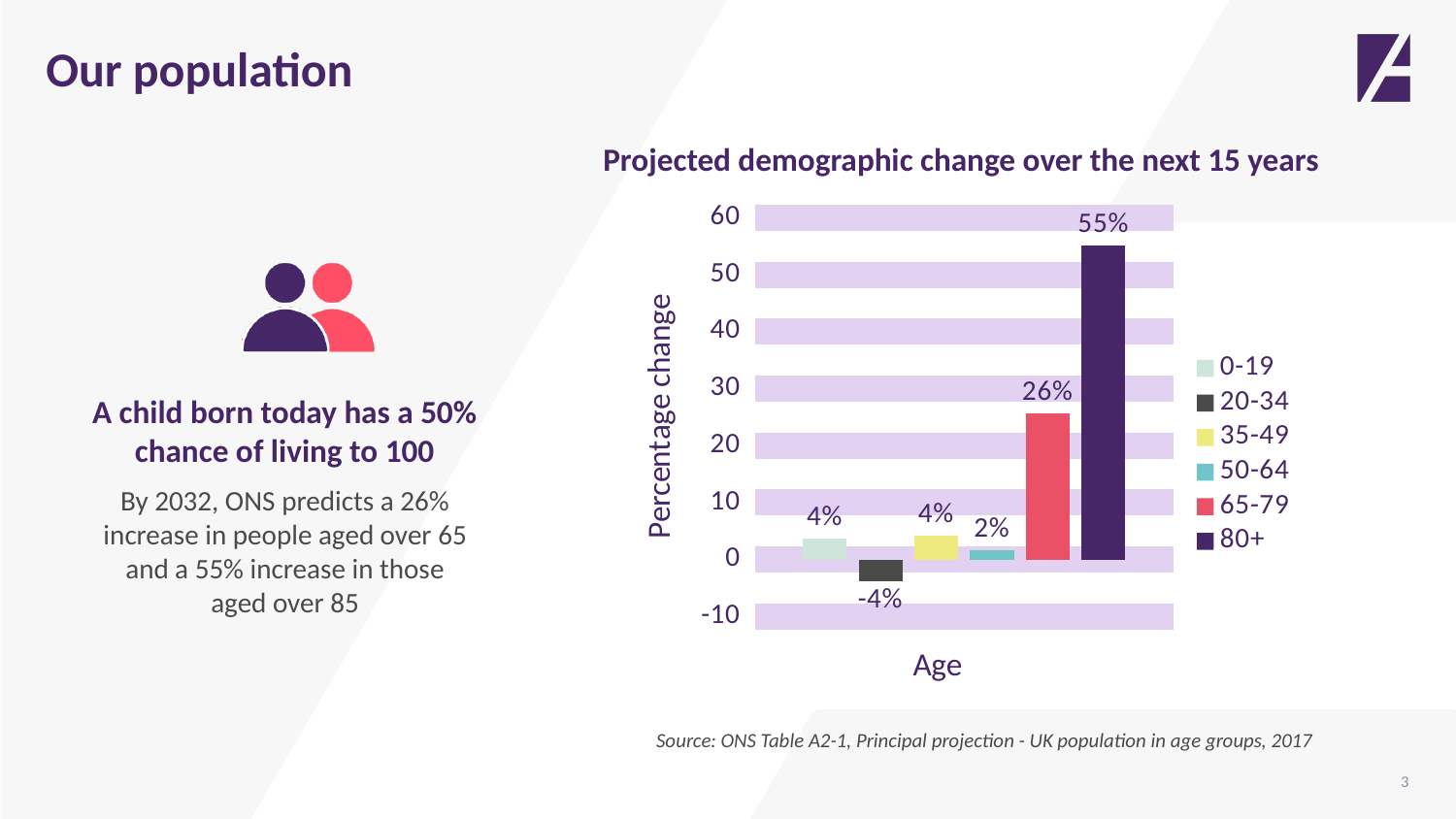
Which age group has the highest projected percentage change? 80+ What is the projected percentage change for the 20-34 age group? -4% Which has a larger projected percentage change, the 35-49 group or the 50-64 group? 35-49 What is the title of the chart? Projected demographic change over the next 15 years What type of chart is shown on the slide? Bar chart Which age group has the lowest projected percentage change? 20-34 How many age groups are shown in the chart? 6 What is the projected percentage change for the 65-79 age group? 26% What is the projected percentage change for the 50-64 age group? 2% How many entries does the legend list? 6 What is the difference in projected percentage change between the 80+ and 65-79 age groups? 29 percentage points What is the projected percentage change for the 80+ age group? 55%